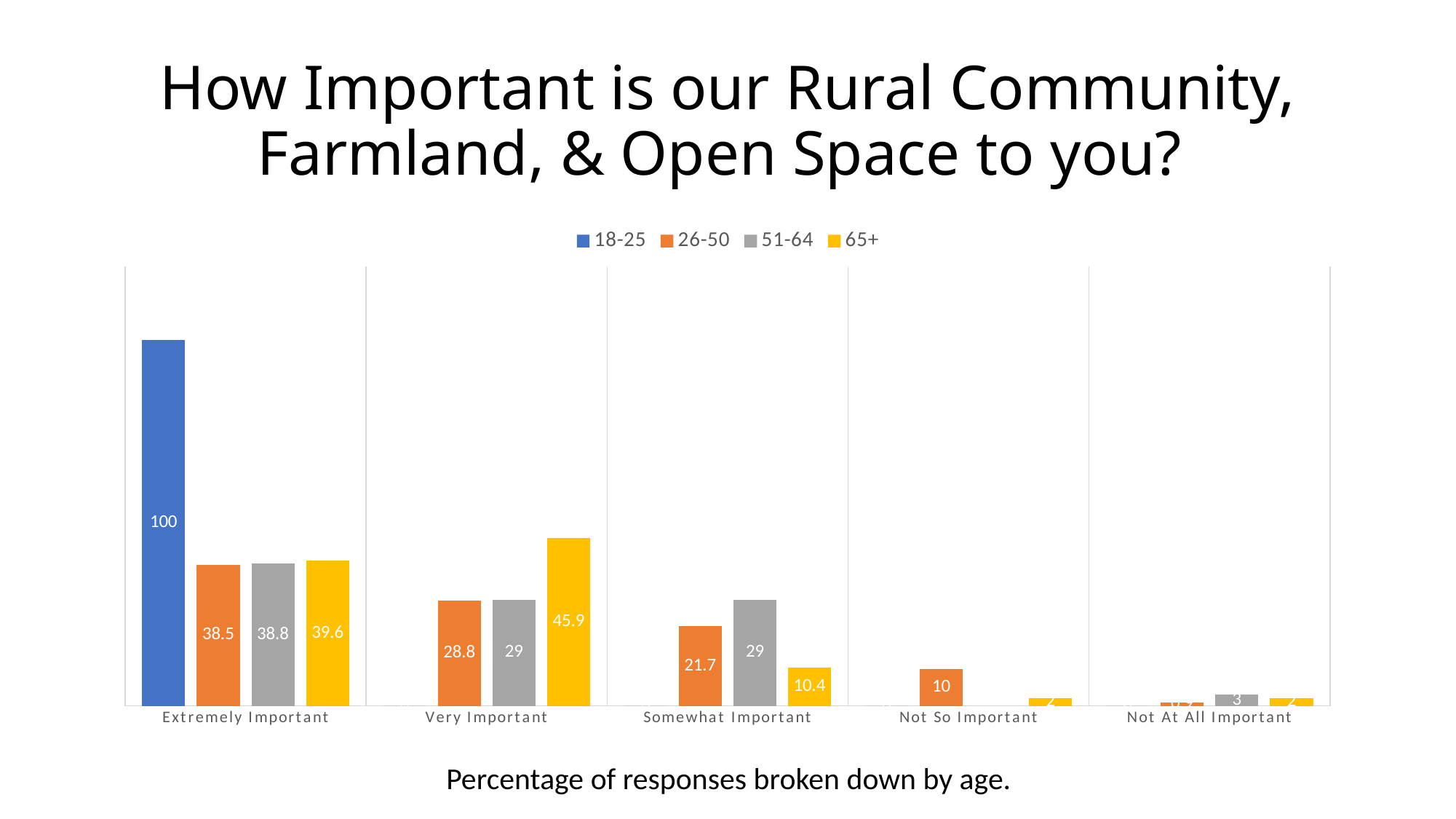
How many age groups does the legend list? 4 What kind of chart is shown on the slide? bar chart What is the value for the 65+ age group under Very Important? 45.9 What colour represents the 65+ age group in the legend? yellow What is the difference between the 65+ and 26-50 values under Very Important? 17.1 What is the value for the 26-50 age group under Not So Important? 10 How many importance categories are shown on the x axis? 5 Which age group has the highest value under Extremely Important? 18-25 Under Somewhat Important, which is larger: the 51-64 value or the 26-50 value? 51-64 What is the value for the 18-25 age group under Extremely Important? 100 What is the value for the 26-50 age group under Somewhat Important? 21.7